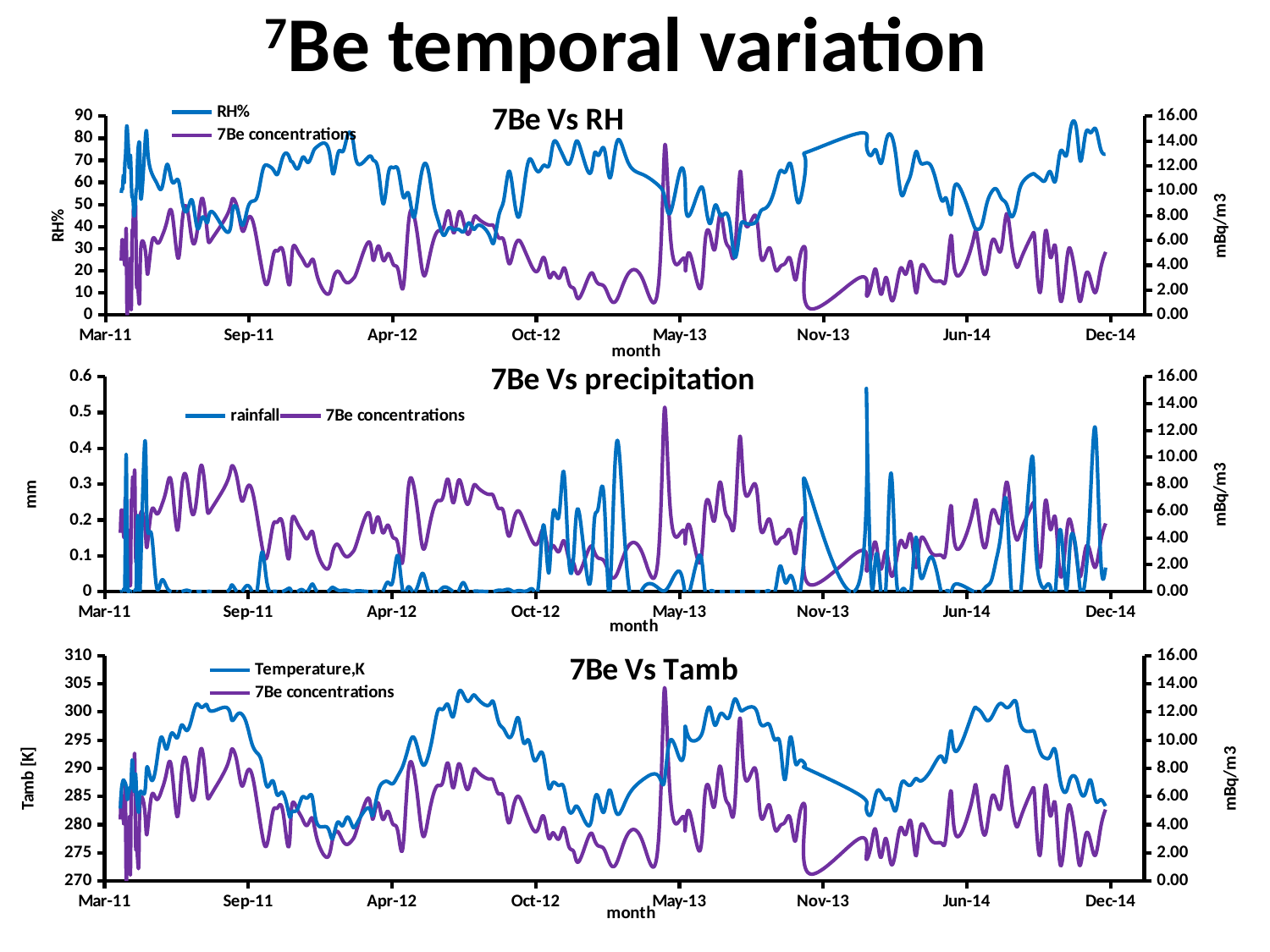
In the "7Be Vs RH" chart, is the lowest 7Be concentration value less or greater than 2.00? less What is the title of the left vertical axis of the "7Be Vs Tamb" chart? Tamb [K] In the "7Be Vs RH" chart, is the highest RH% value reached greater or less than 80? greater In the "7Be Vs precipitation" chart, is the highest rainfall value greater or less than 0.5? greater Which two series are listed in the legend of the "7Be Vs precipitation" chart? rainfall and 7Be concentrations How many series does the legend of the "7Be Vs precipitation" chart list? 2 In the "7Be Vs Tamb" chart, does the temperature rise or fall between Apr-12 and Jun-12? rise In the "7Be Vs Tamb" chart, is the temperature higher around Jun-12 or around Sep-11? Jun-12 What kind of chart is the "7Be Vs RH" chart? line chart